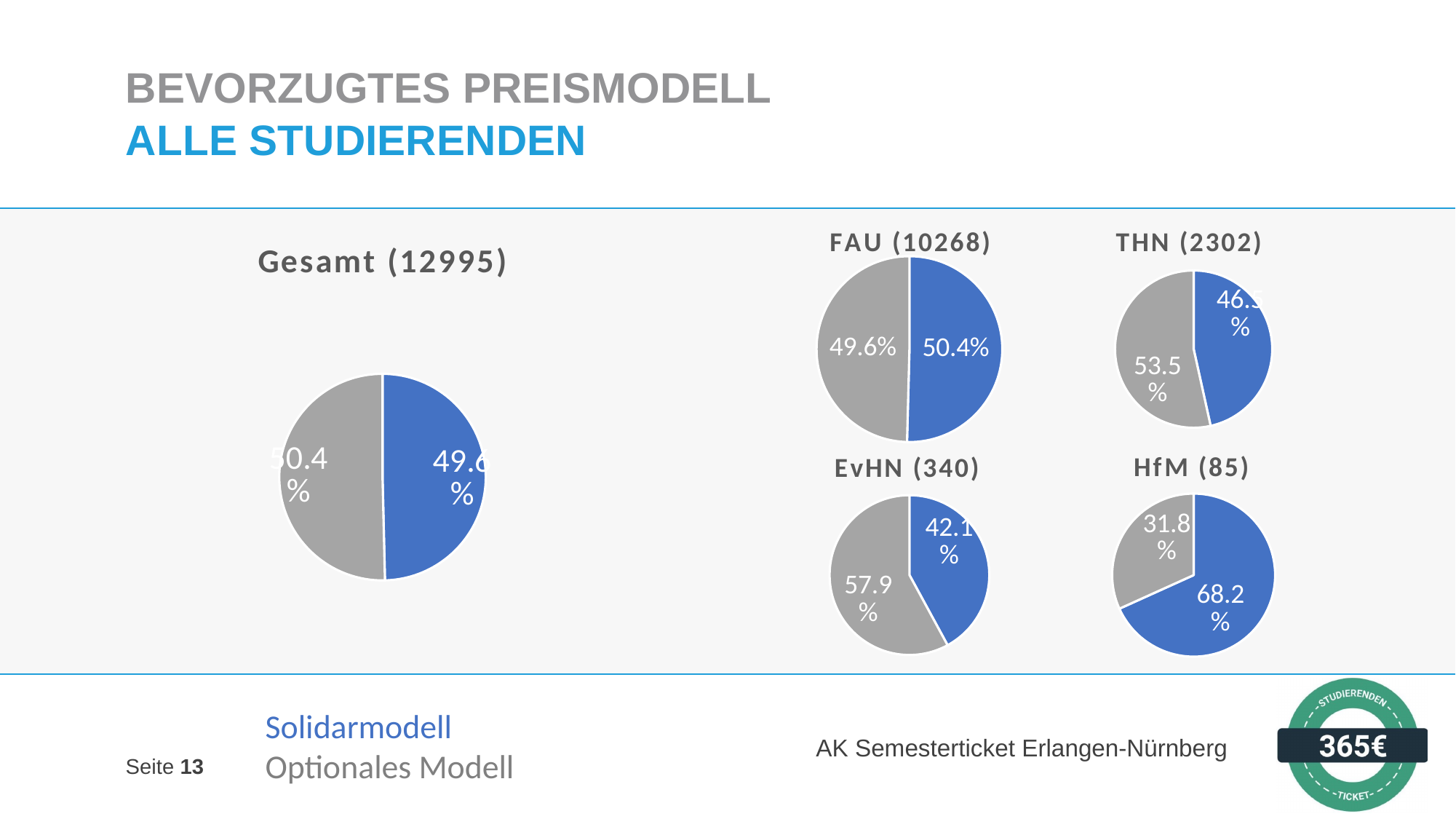
In the 'HfM (85)' pie chart, what is the difference between the Solidarmodell and Optionales Modell shares? 36.4% What type of chart is used for 'Gesamt (12995)'? Pie chart In the 'EvHN (340)' pie chart, what is the value of the Solidarmodell (blue) slice? 42.1% How many pie charts are shown on the slide? 5 In the 'Gesamt (12995)' pie chart, what share does the Optionales Modell (grey) slice have? 50.4% In the 'FAU (10268)' pie chart, what is the value of the Solidarmodell (blue) slice? 50.4% In the 'HfM (85)' pie chart, what is the value of the Solidarmodell (blue) slice? 68.2% In the 'HfM (85)' pie chart, which slice is larger, Solidarmodell or Optionales Modell? Solidarmodell In the 'Gesamt (12995)' pie chart, what share does the Solidarmodell (blue) slice have? 49.6% Which colour represents the Solidarmodell in the pie charts? Blue In the 'EvHN (340)' pie chart, what is the difference between the Optionales Modell and Solidarmodell shares? 15.8% In the 'THN (2302)' pie chart, what is the value of the Optionales Modell (grey) slice? 53.5%